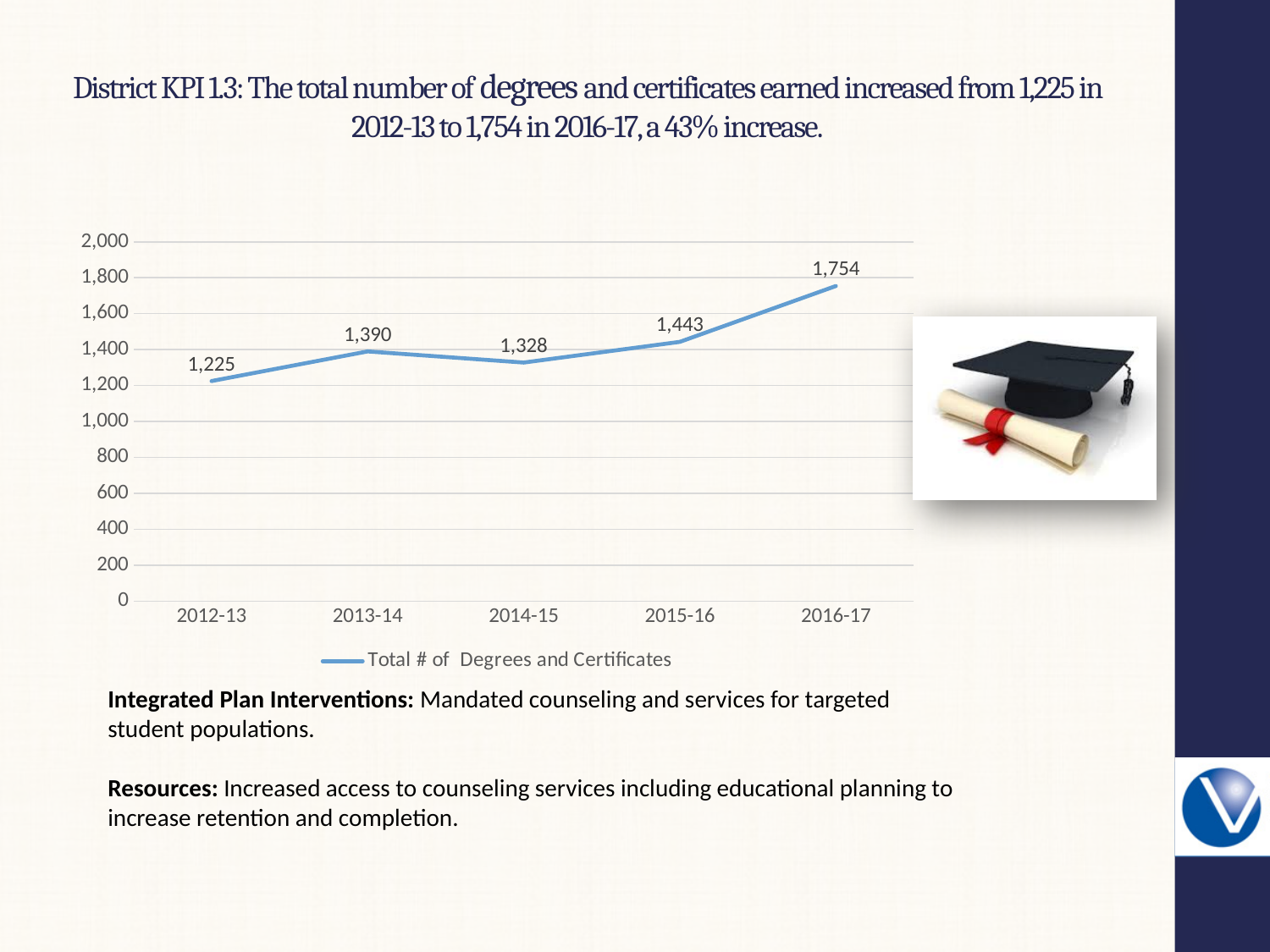
What is the total number of degrees and certificates for 2016-17? 1,754 What is the name of the series shown in the legend? Total # of Degrees and Certificates Which year has the highest total number of degrees and certificates? 2016-17 Which is larger, the value for 2013-14 or the value for 2015-16? 2015-16 What is the total number of degrees and certificates for 2014-15? 1,328 Is the value for 2015-16 greater or less than 1,400? greater How many years are plotted on the chart? 5 Which year has the lowest total number of degrees and certificates? 2012-13 What is the difference between the 2013-14 and 2014-15 values? 62 What is the total number of degrees and certificates for 2012-13? 1,225 What kind of chart is shown on the slide? line chart What is the difference between the 2016-17 and 2012-13 values? 529